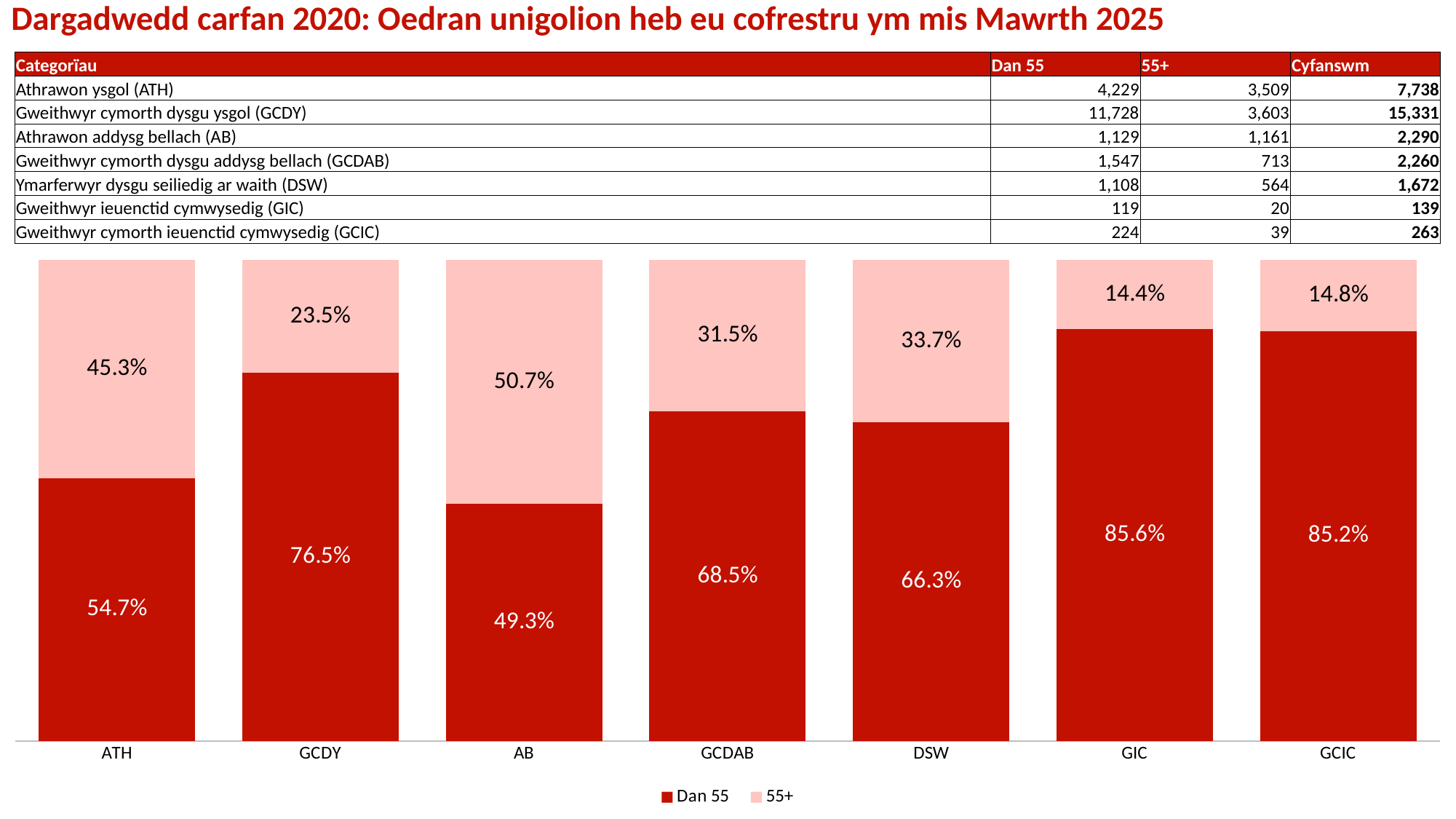
What is the 55+ percentage for GIC in the chart? 14.4% What kind of chart is shown on the slide? Stacked bar chart What is the Dan 55 percentage for ATH in the chart? 54.7% How many categories are shown on the x axis of the chart? 7 How many series does the chart's legend list? 2 What are the two entries in the chart's legend? Dan 55 and 55+ In the chart, how many percentage points higher is the Dan 55 share than the 55+ share for GCDY? 53.0 Which category has the highest 55+ percentage in the chart? AB What is the Dan 55 percentage for DSW in the chart? 66.3% Which category has the lowest Dan 55 percentage in the chart? AB Which has the larger Dan 55 percentage in the chart, GCDAB or DSW? GCDAB What is the 55+ percentage for GCDAB in the chart? 31.5%